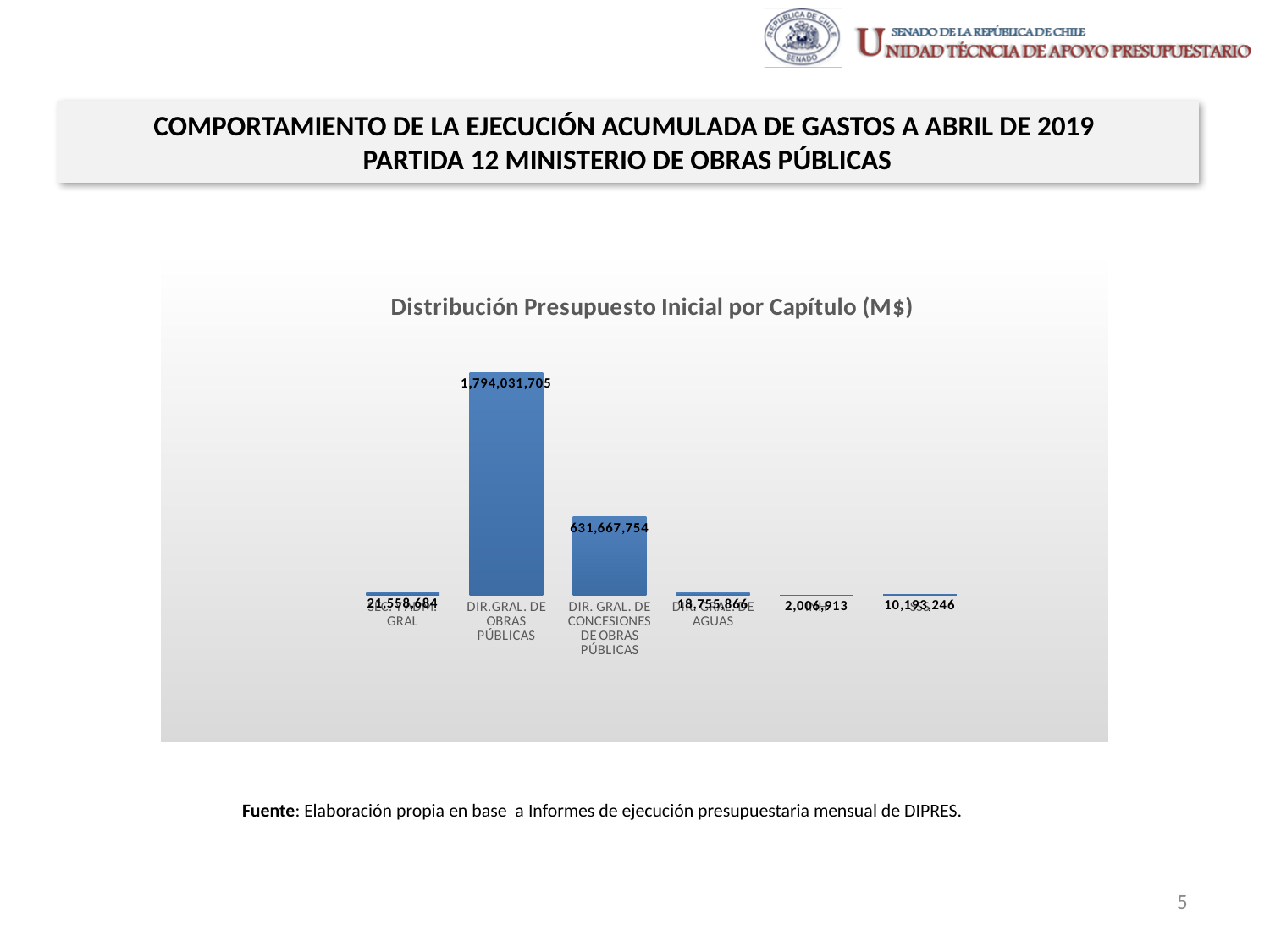
How many bars are plotted in the chart? 6 Which capítulo has the highest initial budget in the chart? DIR.GRAL. DE OBRAS PÚBLICAS Which is larger, the value for DIR. GRAL. DE CONCESIONES DE OBRAS PÚBLICAS or for DIR. GRAL. DE AGUAS? DIR. GRAL. DE CONCESIONES DE OBRAS PÚBLICAS What is the value for DIR. GRAL. DE CONCESIONES DE OBRAS PÚBLICAS? 631,667,754 What kind of chart is shown on the slide? Bar chart What is the value for DIR.GRAL. DE OBRAS PÚBLICAS in the chart? 1,794,031,705 What is the title of the chart? Distribución Presupuesto Inicial por Capítulo (M$) What is the difference between the values for DIR. GRAL. DE CONCESIONES DE OBRAS PÚBLICAS and DIR. GRAL. DE AGUAS? 612,911,888 In what unit are the chart values expressed, according to the title? M$ What is the value for DIR. GRAL. DE AGUAS? 18,755,866 What is the difference between the values for DIR.GRAL. DE OBRAS PÚBLICAS and DIR. GRAL. DE CONCESIONES DE OBRAS PÚBLICAS? 1,162,363,951 What is the smallest value labelled on the chart? 2,006,913